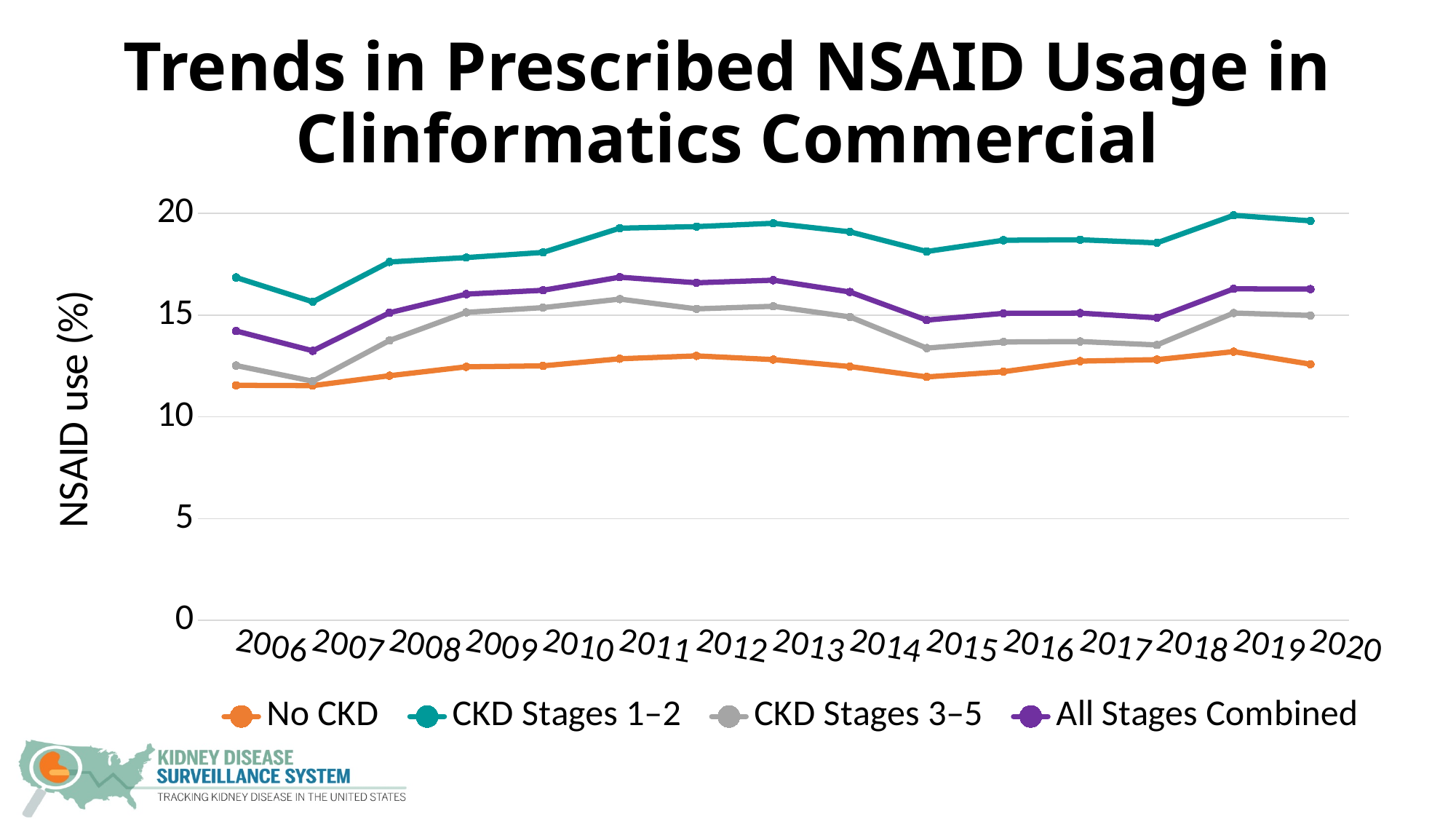
Which series has the highest values across all years? CKD Stages 1–2 In which year does the All Stages Combined series reach its lowest value? 2007 Is the value for CKD Stages 1–2 in 2019 greater or less than 15? greater Which is higher in 2015, CKD Stages 3–5 or All Stages Combined? All Stages Combined Is the value for No CKD in 2006 greater or less than 15? less How many series does the legend list? 4 What kind of chart is shown on the slide? Line chart In which year does the CKD Stages 1–2 series reach its lowest value? 2007 How many years are shown along the x axis? 15 Does the No CKD series rise or fall from 2006 to 2011? Rise What is the label on the y axis? NSAID use (%) Which series has the lowest values across all years? No CKD